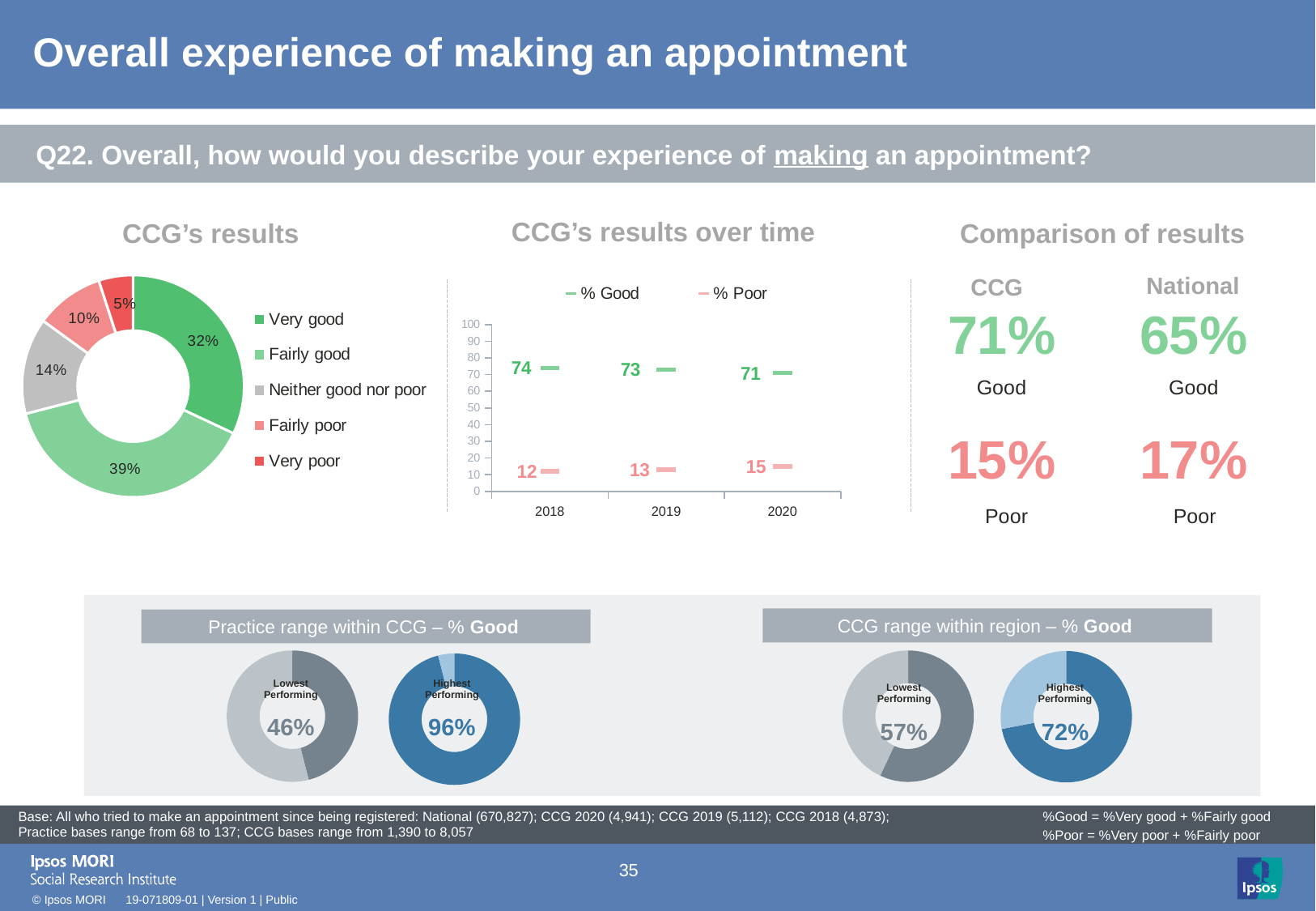
In the "CCG's results" donut chart, which category has the smallest share? Very poor In the "Practice range within CCG – % Good" donuts, what is the Highest Performing value? 96% In the "CCG's results over time" chart, what is the difference between % Good and % Poor in 2019? 60 In the "CCG's results over time" chart, does the % Good series rise or fall from 2018 to 2020? fall In the "Comparison of results" section, which is higher for % Good, CCG or National? CCG In the "CCG's results over time" chart, what is the % Good value for 2018? 74 In the "CCG's results" donut chart, how many categories does the legend list? 5 In the "CCG's results over time" chart, how many series does the legend list? 2 In the "CCG's results over time" chart, what is the % Poor value for 2020? 15 In the "CCG's results" donut chart, which category has the largest share? Fairly good In the "CCG's results" donut chart, what percentage is shown for Fairly good? 39% In the "CCG's results" donut chart, what percentage is shown for Very poor? 5%